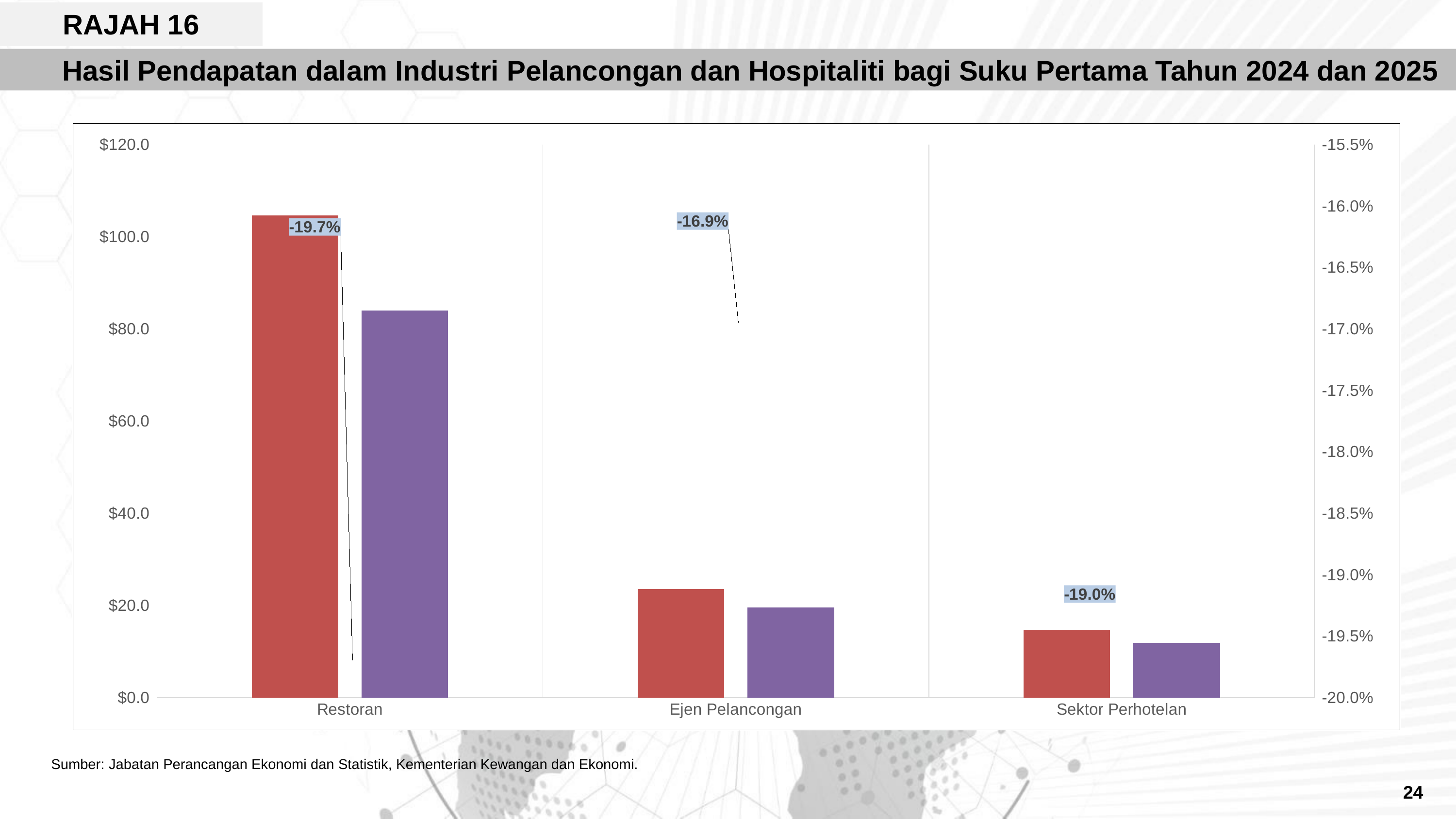
What kind of chart is shown on the slide? combination bar and line chart What percentage change is labelled for Restoran? -19.7% What percentage change is labelled for Sektor Perhotelan? -19.0% Is the red bar for Ejen Pelancongan greater or less than $40.0? less What is the title of the chart on the slide? Hasil Pendapatan dalam Industri Pelancongan dan Hospitaliti bagi Suku Pertama Tahun 2024 dan 2025 Which category has the tallest red bar? Restoran Is the red bar for Restoran greater or less than $100.0? greater For Restoran, which bar is taller, the red bar or the purple bar? the red bar Which category has the shortest red bar? Sektor Perhotelan What percentage change is labelled for Ejen Pelancongan? -16.9% How many categories are shown on the x axis of the chart? 3 Which category has the percentage change label closest to zero? Ejen Pelancongan